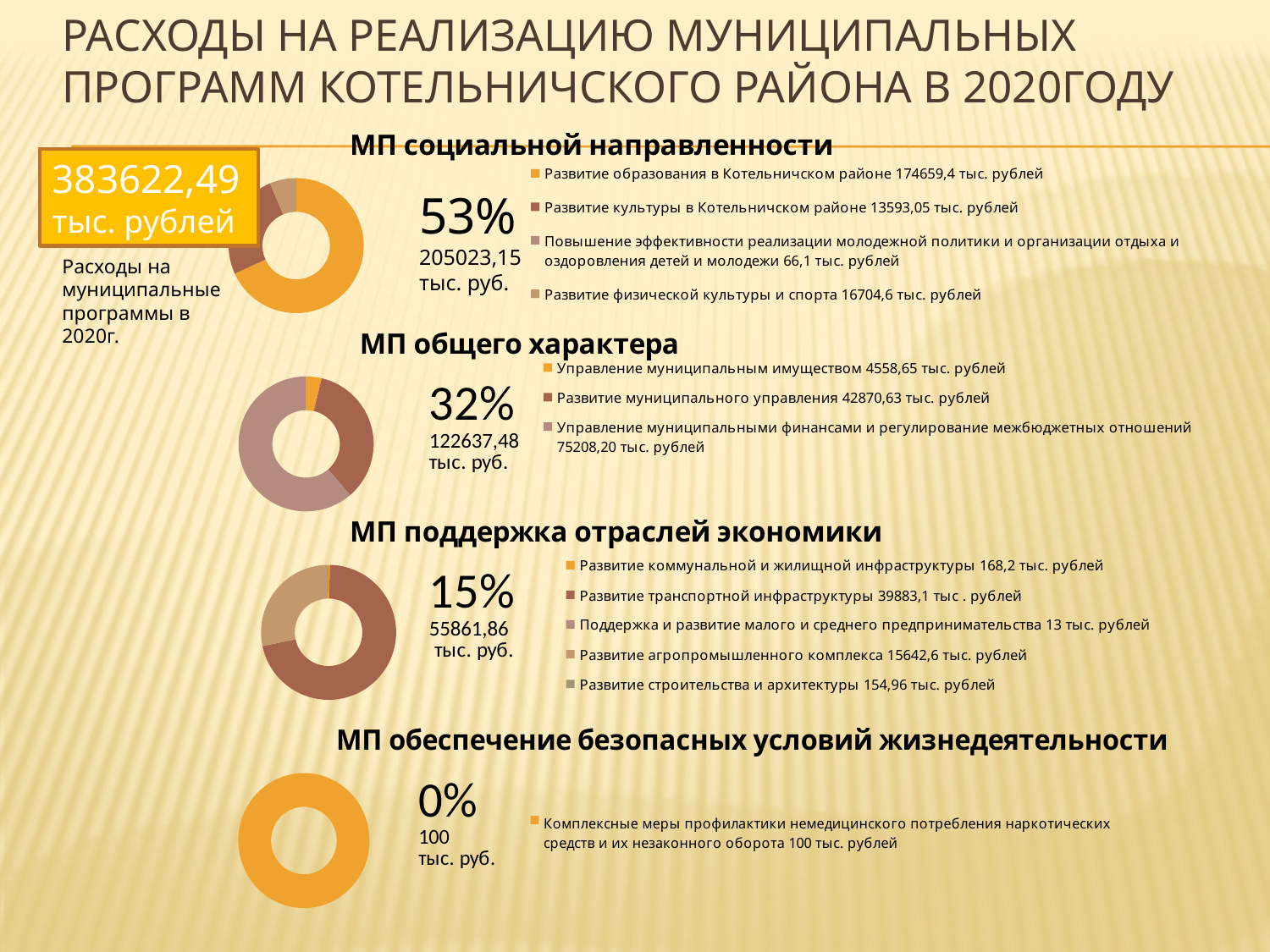
On the 'МП общего характера' chart, what is the difference between 'Управление муниципальными финансами и регулирование межбюджетных отношений' and 'Развитие муниципального управления'? 32337,57 тыс. рублей On the 'МП социальной направленности' chart, what is the value for 'Развитие образования в Котельничском районе'? 174659,4 тыс. рублей What is the total for the 'МП общего характера' chart? 122637,48 тыс. руб. On the 'МП социальной направленности' chart, what is the difference between 'Развитие образования в Котельничском районе' and 'Развитие физической культуры и спорта'? 157954,8 тыс. рублей What kind of chart is used for 'МП обеспечение безопасных условий жизнедеятельности'? Doughnut chart On the 'МП поддержка отраслей экономики' chart, which is larger: 'Развитие транспортной инфраструктуры' or 'Развитие агропромышленного комплекса'? Развитие транспортной инфраструктуры On the 'МП общего характера' chart, what is the value for 'Развитие муниципального управления'? 42870,63 тыс. рублей How many categories does the 'МП поддержка отраслей экономики' chart show? 5 On the 'МП социальной направленности' chart, which category has the smallest value? Повышение эффективности реализации молодежной политики и организации отдыха и оздоровления детей и молодежи What share of total expenditure does the 'МП социальной направленности' chart represent? 53% On the 'МП общего характера' chart, which category has the largest value? Управление муниципальными финансами и регулирование межбюджетных отношений On the 'МП поддержка отраслей экономики' chart, what is the value for 'Поддержка и развитие малого и среднего предпринимательства'? 13 тыс. рублей